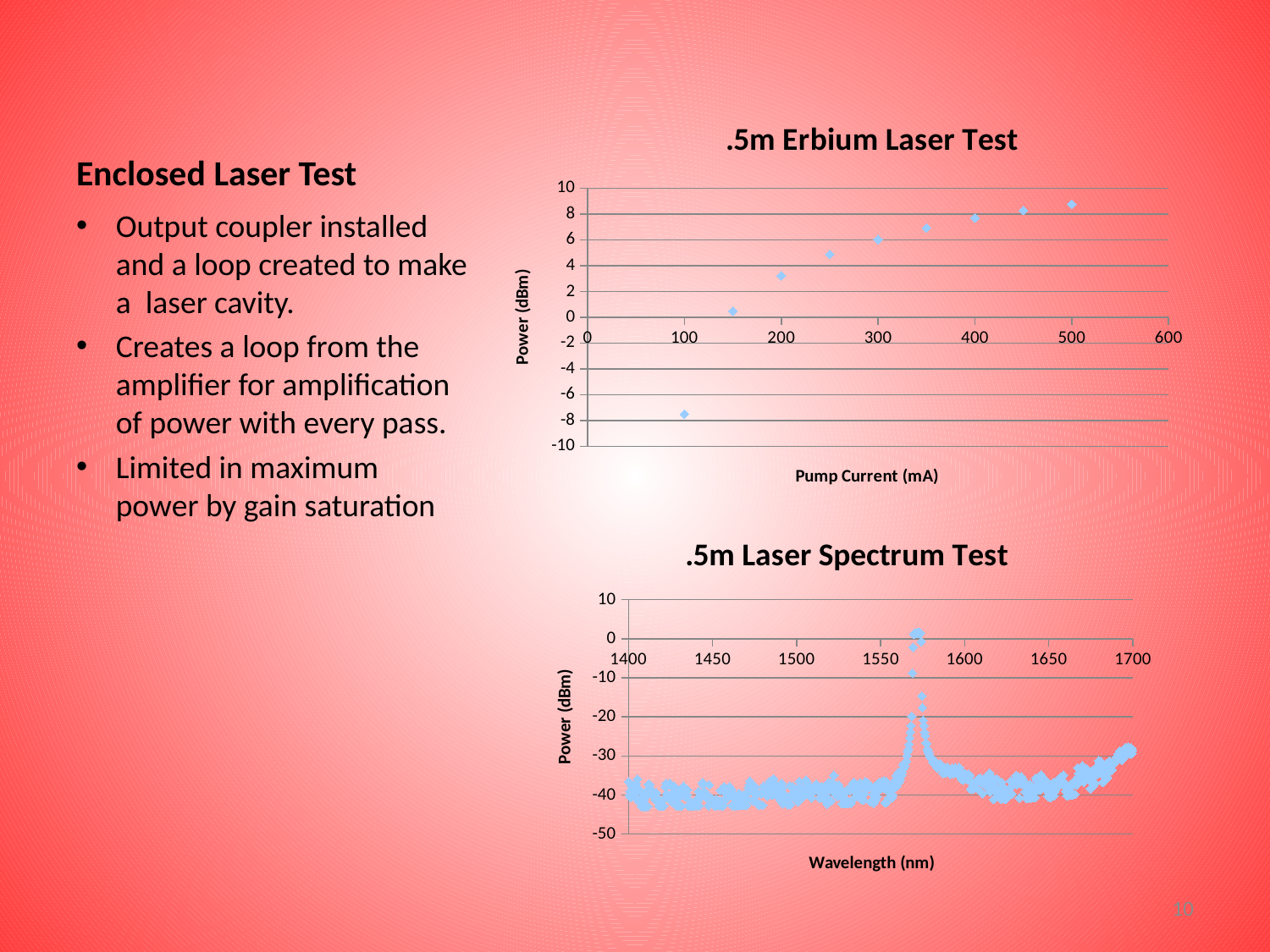
In the '.5m Erbium Laser Test' chart, is the power at a pump current of 300 mA greater or less than 8 dBm? less In the '.5m Erbium Laser Test' chart, is the power at a pump current of 100 mA greater or less than -6 dBm? less In the '.5m Erbium Laser Test' chart, is the power at a pump current of 200 mA greater or less than 2 dBm? greater What type of chart is the '.5m Erbium Laser Test' chart? scatter chart How many data points are plotted in the '.5m Erbium Laser Test' chart? 9 In the '.5m Erbium Laser Test' chart, does power rise or fall as pump current increases? rise In the '.5m Erbium Laser Test' chart, at which pump current is the power highest? 500 mA In the '.5m Erbium Laser Test' chart, at which pump current is the power lowest? 100 mA What is the x-axis label of the '.5m Laser Spectrum Test' chart? Wavelength (nm)